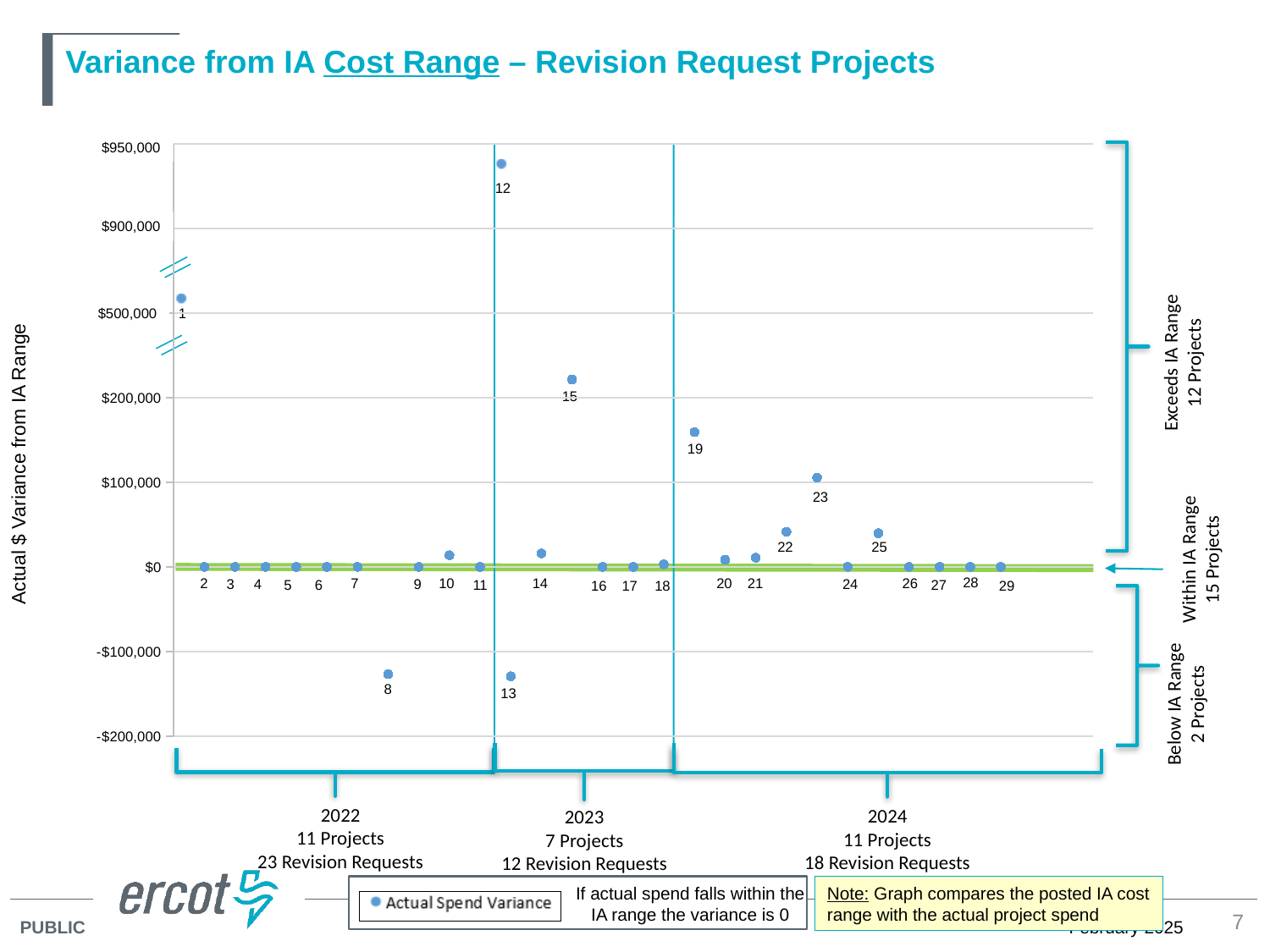
Is the value for project 19 greater or less than $100,000? greater Is the value for project 12 greater or less than $900,000? greater Which numbered project has the highest actual $ variance from IA range? 12 How many numbered project points are plotted on the chart? 29 How many series does the chart legend list? 1 What is the name of the series shown in the chart legend? Actual Spend Variance Which has the larger actual $ variance, project 23 or project 19? project 19 Which has the larger actual $ variance, project 15 or project 19? project 15 Is the value for project 15 greater or less than $200,000? greater What kind of chart is shown on the slide? scatter chart What is the label on the vertical axis of the chart? Actual $ Variance from IA Range